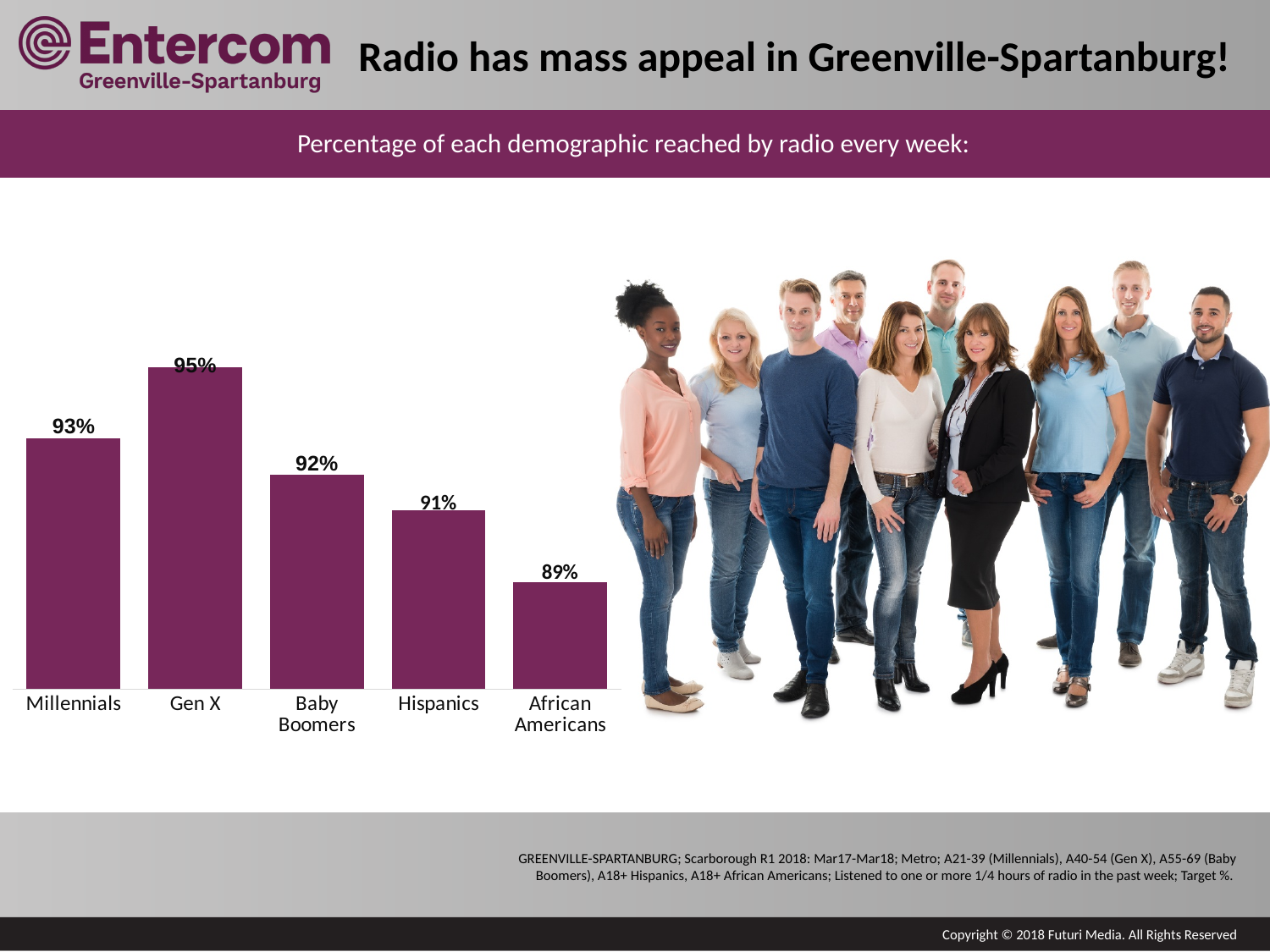
What type of chart is used to show the percentage of each demographic reached by radio? Bar chart What percentage of Millennials are reached by radio every week? 93% Which demographic has the highest percentage reached by radio every week? Gen X What percentage of Gen X is reached by radio every week? 95% What is the difference in percentage points between Gen X and African Americans? 6 percentage points What percentage of African Americans are reached by radio every week? 89% Which demographic has the lowest percentage reached by radio every week? African Americans Which demographic has a higher percentage reached by radio, Millennials or Baby Boomers? Millennials What percentage of Baby Boomers are reached by radio every week? 92% What is the subtitle describing the chart on the slide? Percentage of each demographic reached by radio every week: What percentage of Hispanics are reached by radio every week? 91% How many demographic categories are shown in the chart? 5